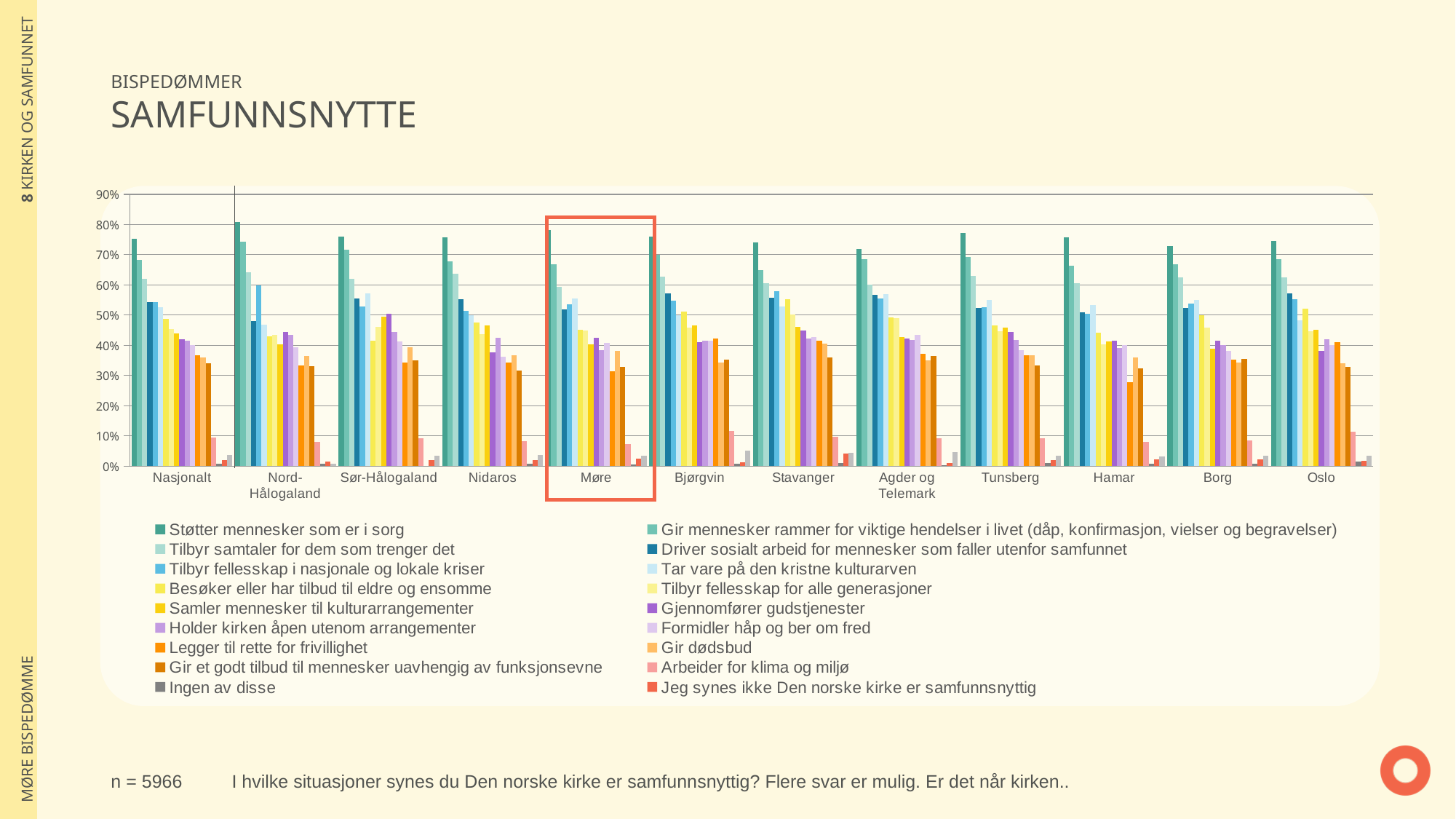
Is the value for 'Støtter mennesker som er i sorg' in Nasjonalt greater or less than 70%? greater Which category on the x axis is highlighted with a red box? Møre In Nord-Hålogaland, which is larger: 'Tilbyr fellesskap i nasjonale og lokale kriser' or 'Driver sosialt arbeid for mennesker som faller utenfor samfunnet'? Tilbyr fellesskap i nasjonale og lokale kriser In the Nasjonalt group, which series has the highest value? Støtter mennesker som er i sorg Is the value for 'Jeg synes ikke Den norske kirke er samfunnsnyttig' in Møre greater or less than 10%? less What kind of chart is shown on the slide? Bar chart How many series does the chart's legend list? 18 What is the title of the chart slide? SAMFUNNSNYTTE How many bispedømme/category groups are shown along the x axis of the chart? 12 Is the value for 'Gir dødsbud' in Hamar greater or less than 40%? less